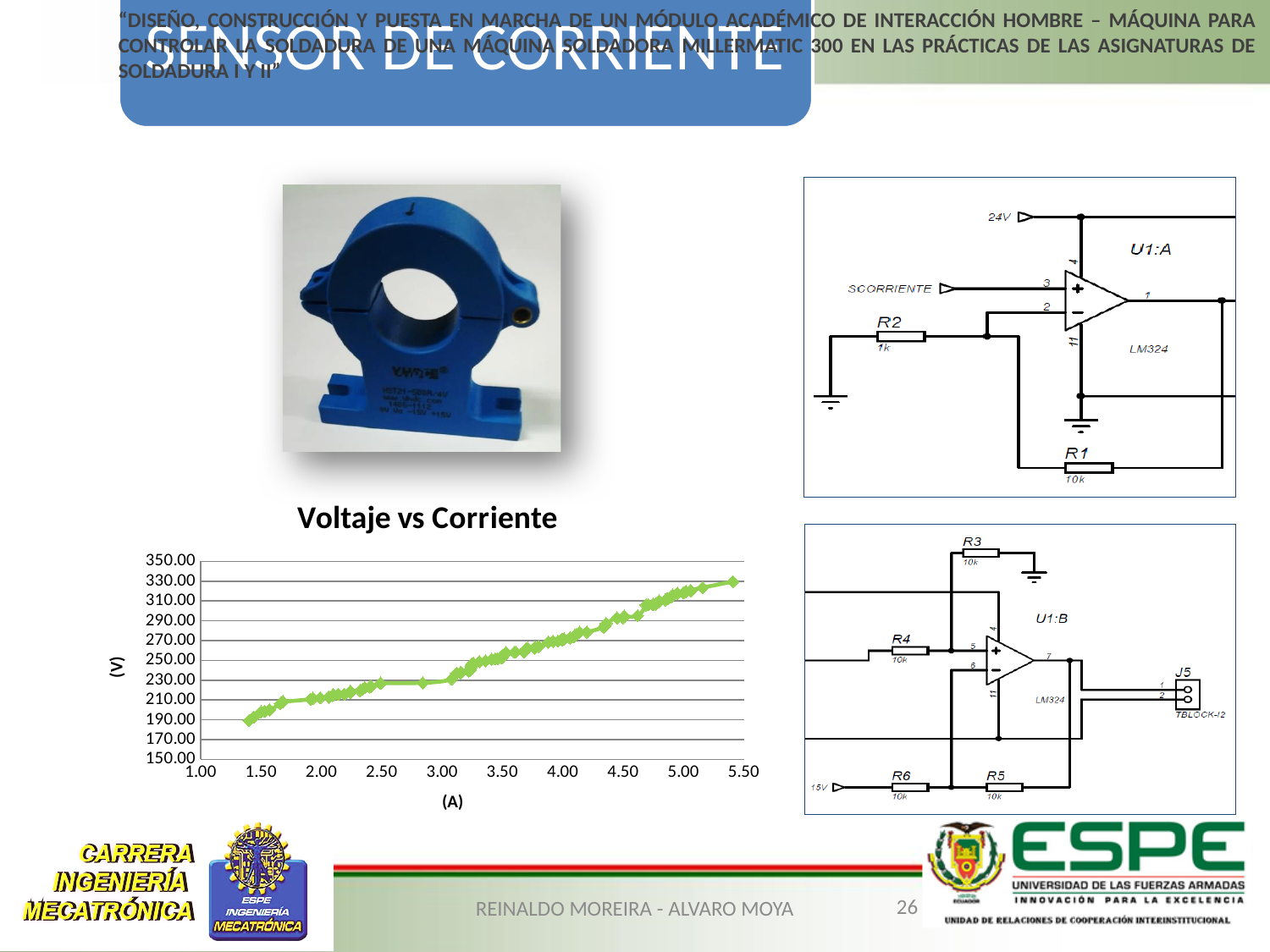
In the 'Voltaje vs Corriente' chart, do the values rise or fall as the current (A) increases? rise What is the label of the vertical axis of the 'Voltaje vs Corriente' chart? (V) In the 'Voltaje vs Corriente' chart, is the value at 2.00 A greater or less than 230.00? less In the 'Voltaje vs Corriente' chart, is the value at 1.50 A greater or less than 210.00? less In the 'Voltaje vs Corriente' chart, is the highest value found at the left end or the right end of the x axis? right end What is the title of the chart on the slide? Voltaje vs Corriente What kind of chart is the 'Voltaje vs Corriente' chart? line chart In the 'Voltaje vs Corriente' chart, is the lowest value found at the left end or the right end of the x axis? left end In the 'Voltaje vs Corriente' chart, is the value at 4.00 A greater or less than 250.00? greater In the 'Voltaje vs Corriente' chart, which is larger: the value at 5.00 A or the value at 2.00 A? the value at 5.00 A